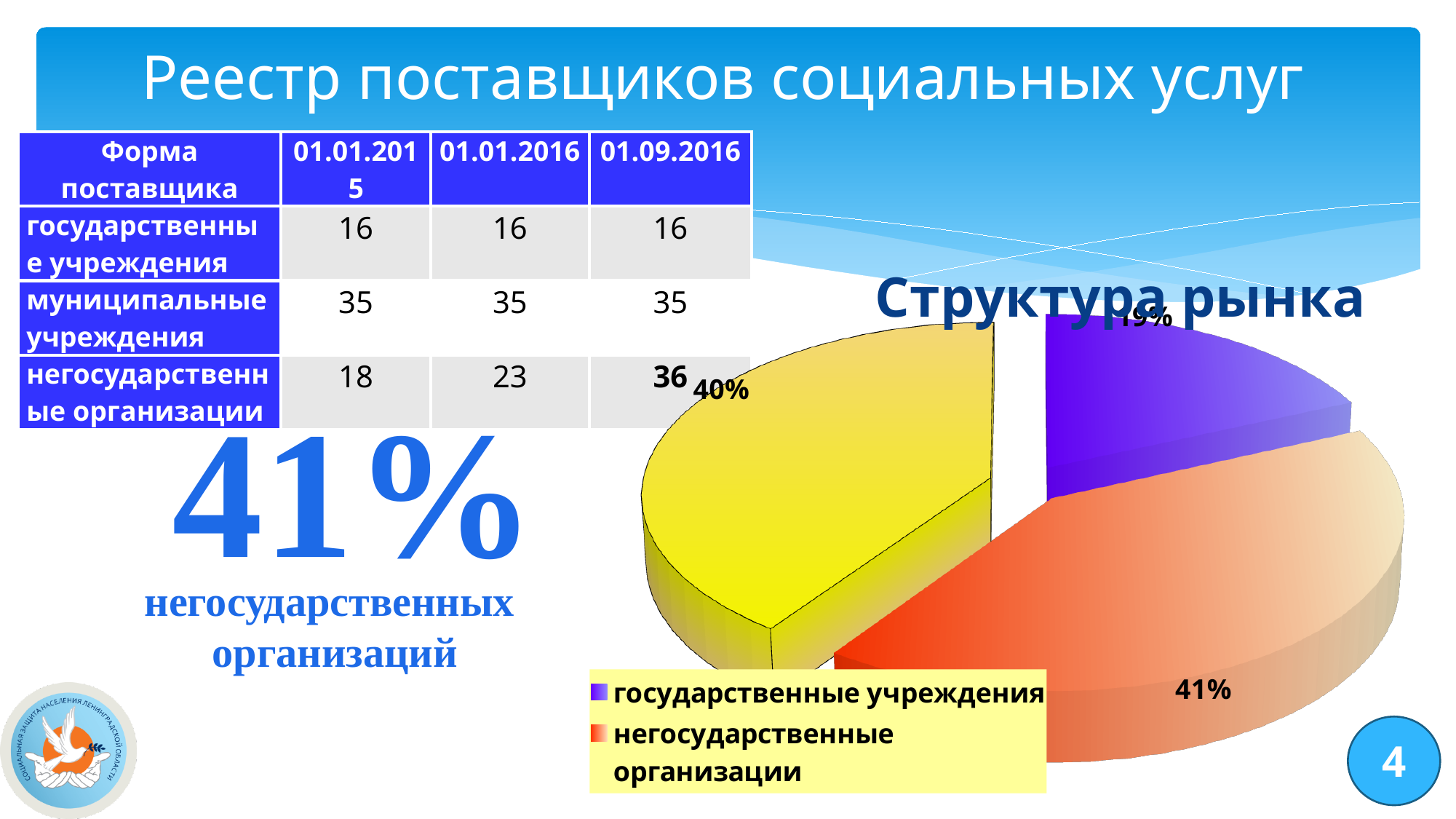
What is the title of the pie chart on the slide? Структура рынка In the "Структура рынка" pie chart, what colour is the slice for негосударственные организации? orange-red In the "Структура рынка" pie chart, what percentage is labelled on the yellow slice? 40% What kind of chart is shown under the title "Структура рынка"? pie chart How many entries are visible in the legend of the "Структура рынка" pie chart? 2 In the "Структура рынка" pie chart, which is larger: the slice for государственные учреждения or the slice for негосударственные организации? негосударственные организации In the "Структура рынка" pie chart, what share is labelled for негосударственные организации? 41% In the "Структура рынка" pie chart, by how many percentage points does the негосударственные организации slice exceed the государственные учреждения slice? 22 percentage points How many slices does the "Структура рынка" pie chart have? 3 In the "Структура рынка" pie chart, what share is labelled for государственные учреждения? 19% In the "Структура рынка" pie chart, which legend category has the smallest slice? государственные учреждения In the "Структура рынка" pie chart, which legend category has the largest slice? негосударственные организации